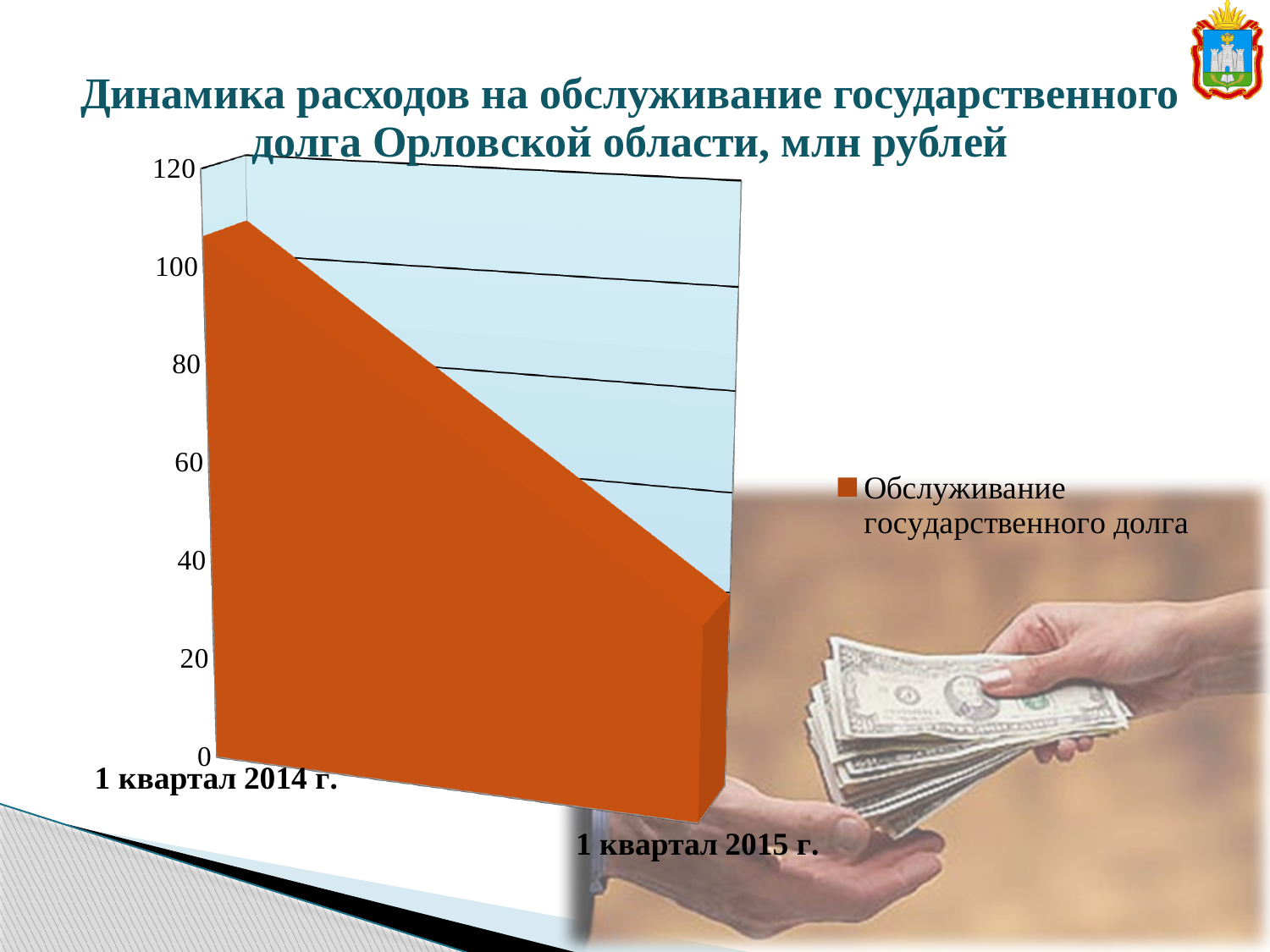
Is the value for 1 квартал 2015 г. greater or less than 20? greater What is the maximum value shown on the vertical axis of the chart? 120 Which period has the lowest value on the chart? 1 квартал 2015 г. How many series does the chart legend list? 1 How many time periods are plotted on the x axis of the chart? 2 What is the name of the series shown in the legend? Обслуживание государственного долга Do the values rise or fall from 1 квартал 2014 г. to 1 квартал 2015 г.? fall Is the value for 1 квартал 2014 г. greater or less than 100? greater Which period has the higher value, 1 квартал 2014 г. or 1 квартал 2015 г.? 1 квартал 2014 г. Is the value for 1 квартал 2015 г. greater or less than 60? less What kind of chart is shown on the slide? area chart